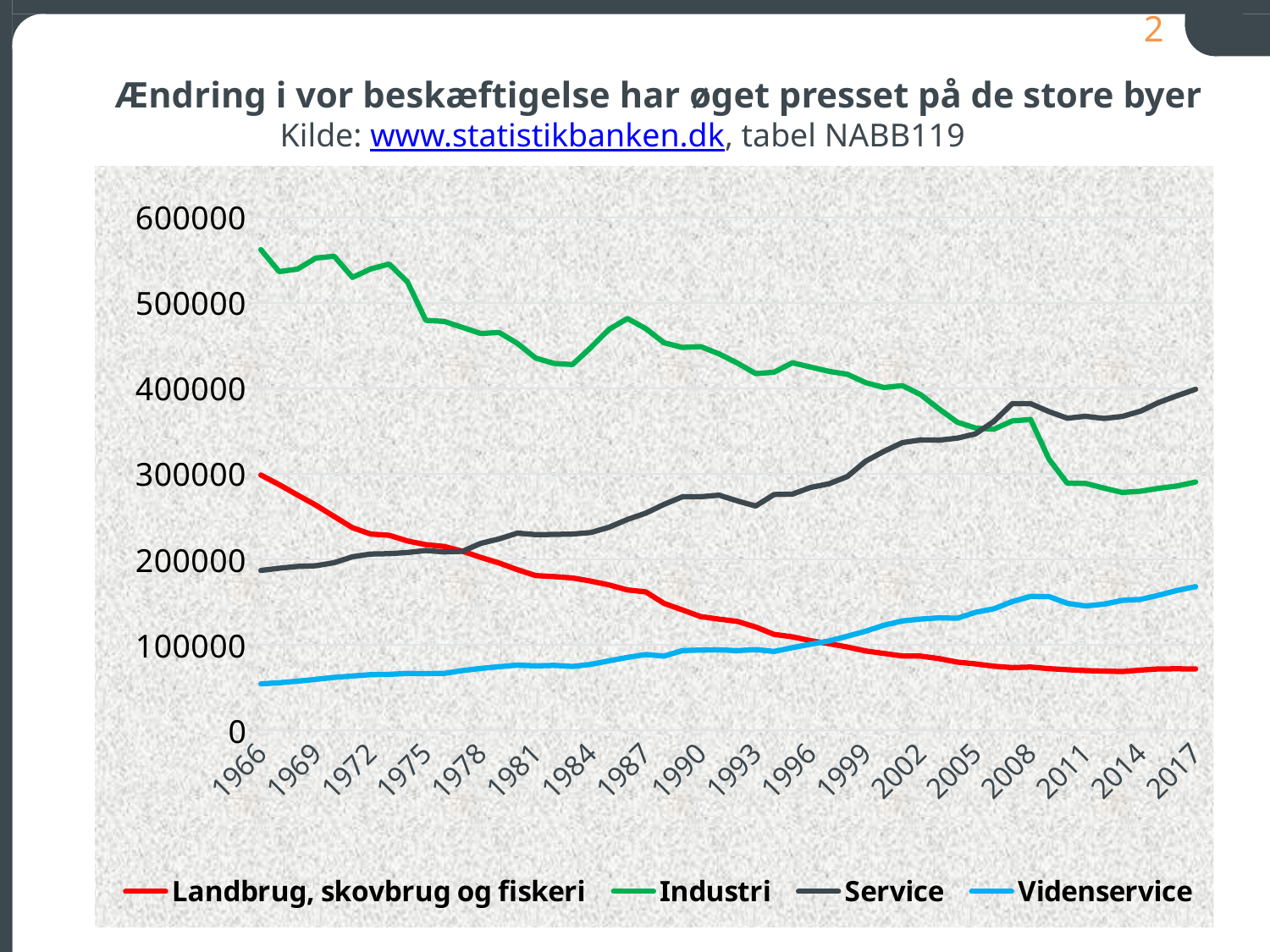
Which series has the lowest value in 2017? Landbrug, skovbrug og fiskeri Is the value for Industri in 1966 greater or less than 500000? greater Is the value for Videnservice in 2017 greater or less than 100000? greater Is the value for Landbrug, skovbrug og fiskeri in 2017 greater or less than 100000? less How many series does the legend list? 4 What colour is the Industri line? Green In 2017, which is larger: Service or Industri? Service Does the Service series rise or fall from 1966 to 2017? Rise What kind of chart is shown on the slide? Line chart Does the Landbrug, skovbrug og fiskeri series rise or fall from 1966 to 2017? Fall Which series has the highest value in 1966? Industri Which series has the highest value in 2017? Service